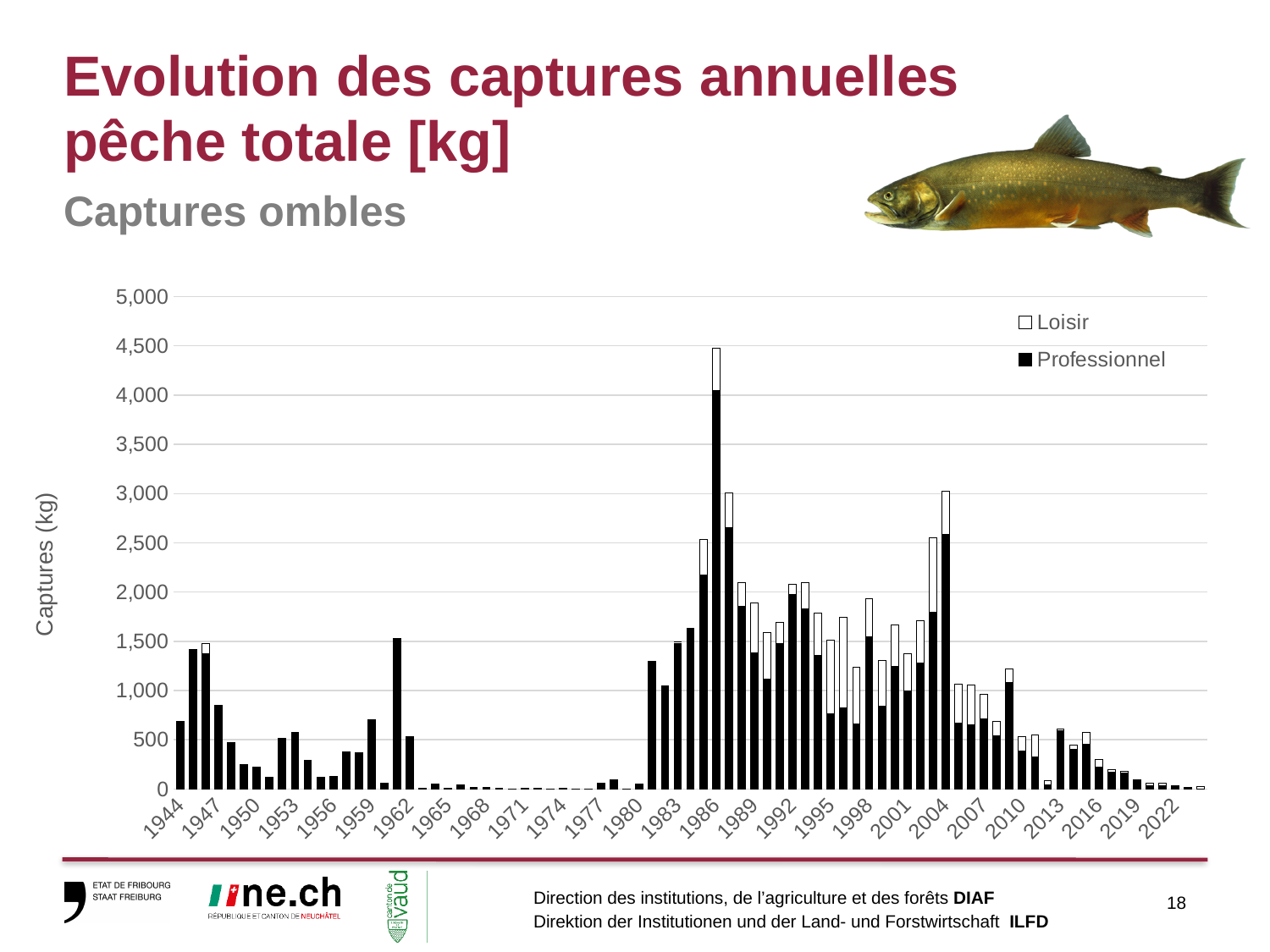
What kind of chart is shown on the slide? stacked bar chart Which year has the highest total catch? 1986 Is the total catch for 1971 greater or less than 500? less Which year has the larger total catch, 1986 or 2004? 1986 What is the label on the vertical axis? Captures (kg) How many series does the legend list? 2 Which year has the larger total catch, 1962 or 1950? 1962 Is the total catch for 1962 greater or less than 1,000? less Is the total catch for 2004 greater or less than 2,500? greater Do the total catches generally rise or fall from 1986 to 2022? fall What are the two series named in the legend? Loisir and Professionnel